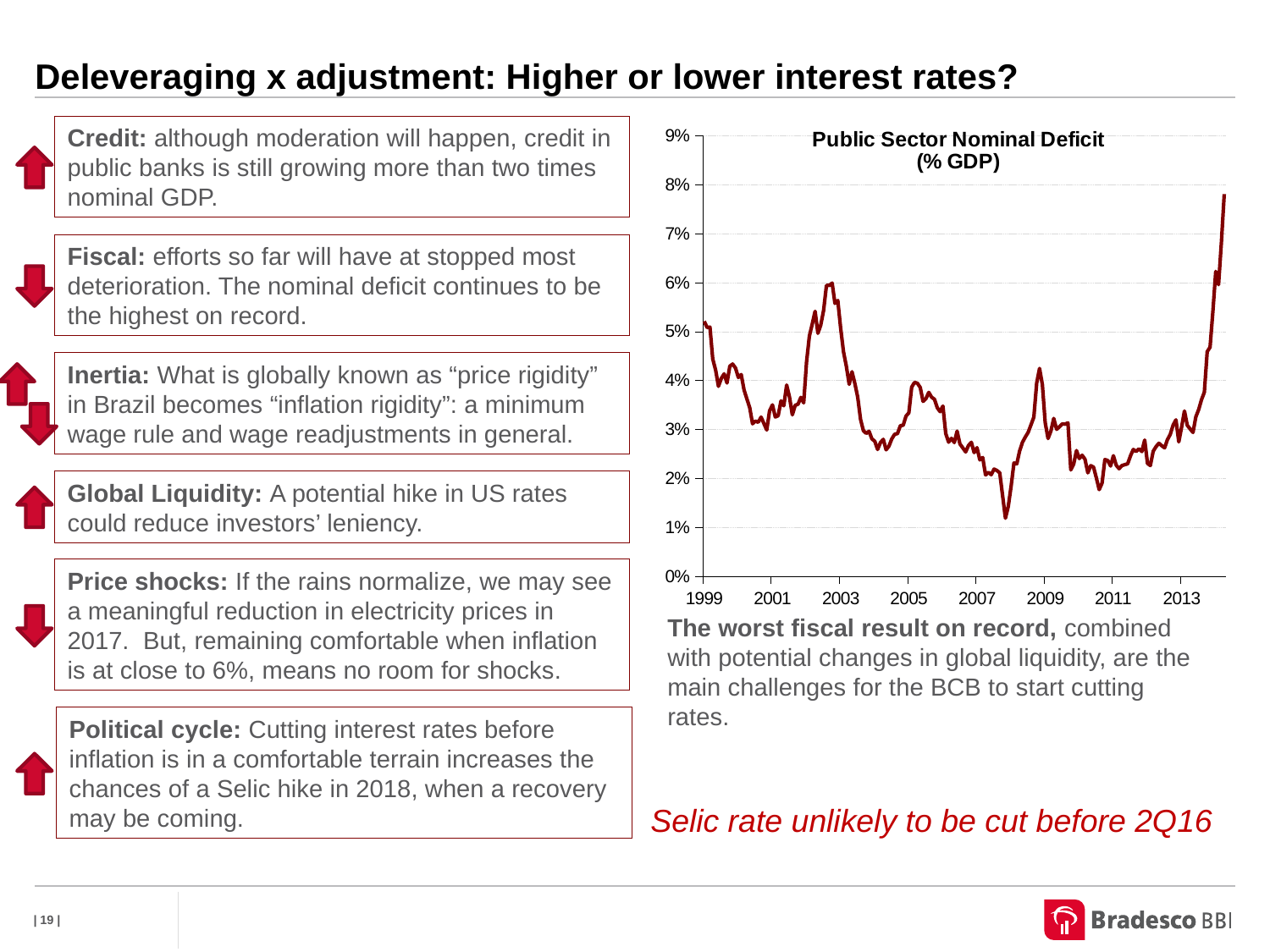
Is the value at the right-hand end of the line (the latest point) greater or less than 7%? greater Is the lowest point of the line, around 2008, greater or less than 2%? less Is the value at the start of the line in 1999 greater or less than 4%? greater How many year labels are shown on the chart's horizontal axis? 8 What is the highest value shown on the chart's vertical axis? 9% Does the line rise or fall between 2011 and the end of the series? rise What is the title of the chart on the slide? Public Sector Nominal Deficit (% GDP) Which is larger: the value at the end of the series or the peak around 2003? the value at the end of the series Does the line rise or fall between 2003 and 2008? fall What kind of chart is shown on the slide? line chart